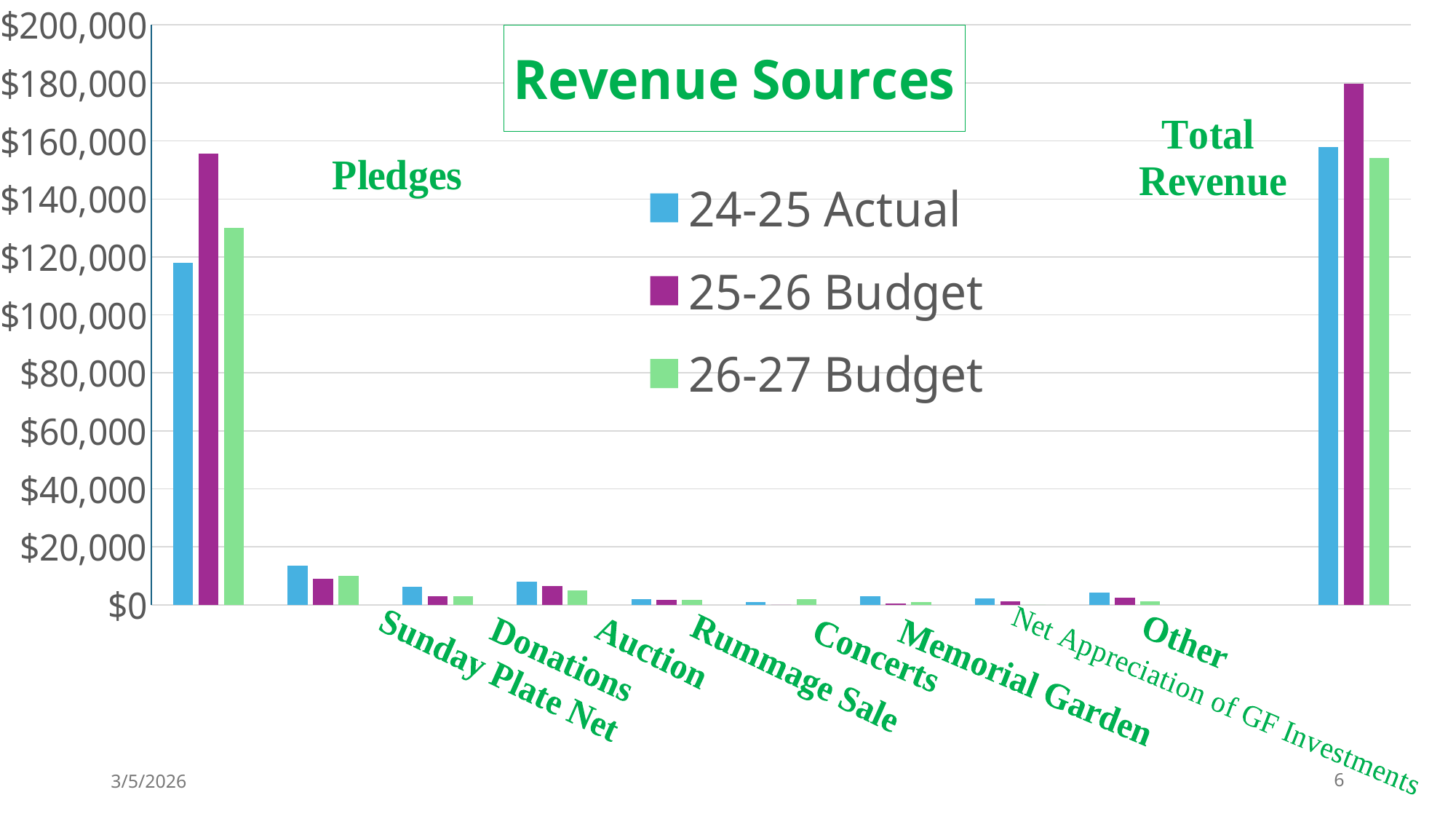
Is the 25-26 Budget value for Total Revenue greater or less than $160,000? greater How many categories are shown along the x axis? 10 Is the 24-25 Actual value for Sunday Plate Net greater or less than $20,000? less What is the title of the chart? Revenue Sources Excluding Total Revenue, which revenue source has the highest 24-25 Actual value? Pledges How many series does the legend list? 3 For Pledges, which is larger: the 24-25 Actual value or the 25-26 Budget value? 25-26 Budget Which category has the lowest 24-25 Actual value? Concerts Is the 25-26 Budget value for Pledges greater or less than $140,000? greater Which category has the highest 25-26 Budget value? Total Revenue For Sunday Plate Net, which is larger: the 24-25 Actual value or the 25-26 Budget value? 24-25 Actual What kind of chart is shown on the slide? bar chart